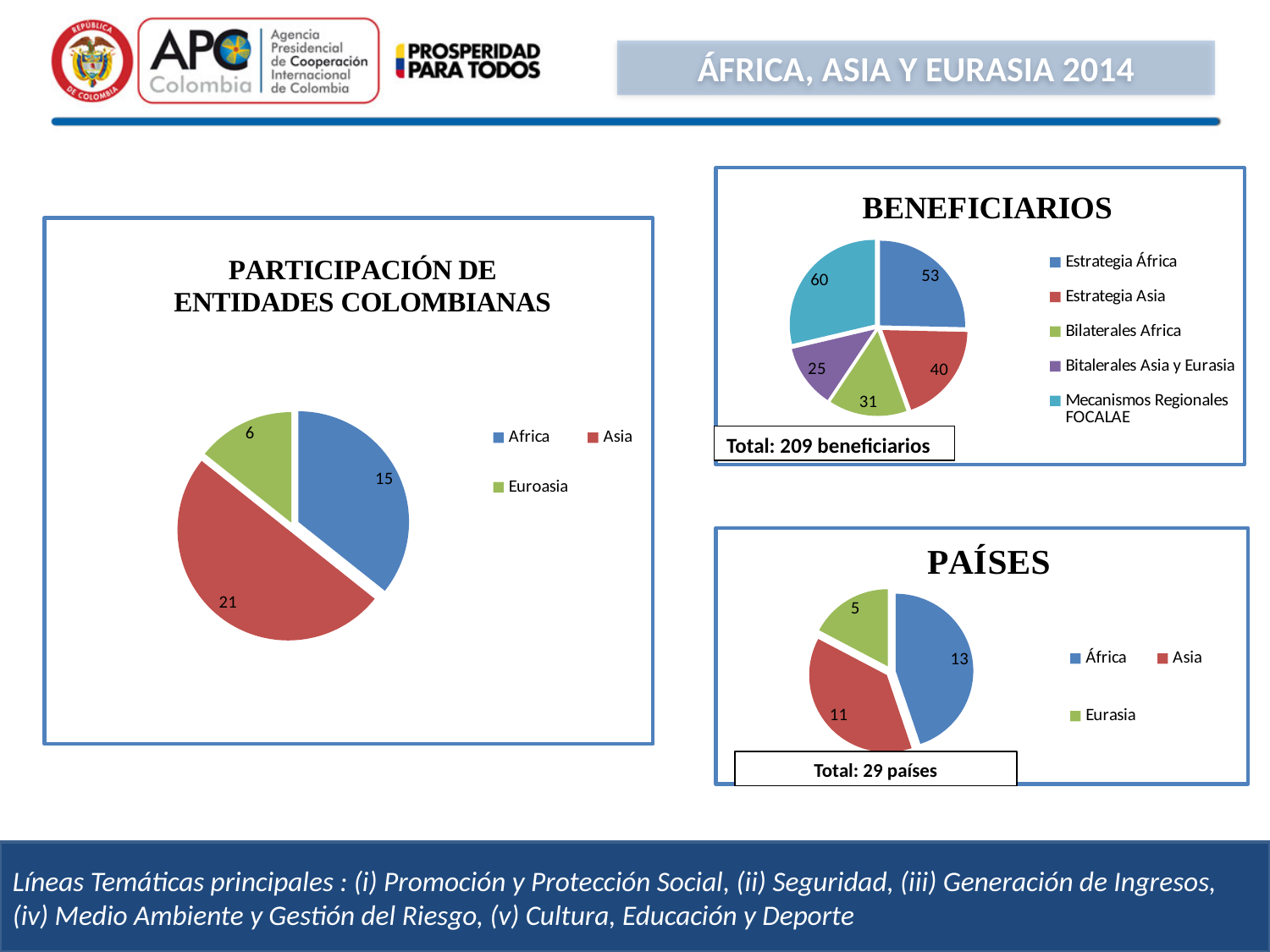
In the BENEFICIARIOS chart, what is the value for Mecanismos Regionales FOCALAE? 60 In the PAÍSES chart, what is the value for Eurasia? 5 In the BENEFICIARIOS chart, what is the difference between Estrategia África and Estrategia Asia? 13 In the BENEFICIARIOS chart, which category has the lowest value? Bitalerales Asia y Eurasia What total is stated below the BENEFICIARIOS chart? Total: 209 beneficiarios In the PARTICIPACIÓN DE ENTIDADES COLOMBIANAS chart, what share of the pie does Asia represent? 50% How many categories does the BENEFICIARIOS chart show? 5 In the PARTICIPACIÓN DE ENTIDADES COLOMBIANAS chart, which category has the smallest slice? Euroasia What type of chart is the PAÍSES chart? Pie chart In the PAÍSES chart, what is the difference between África and Asia? 2 In the PAÍSES chart, which is larger, África or Asia? África In the PARTICIPACIÓN DE ENTIDADES COLOMBIANAS chart, what is the value for Asia? 21